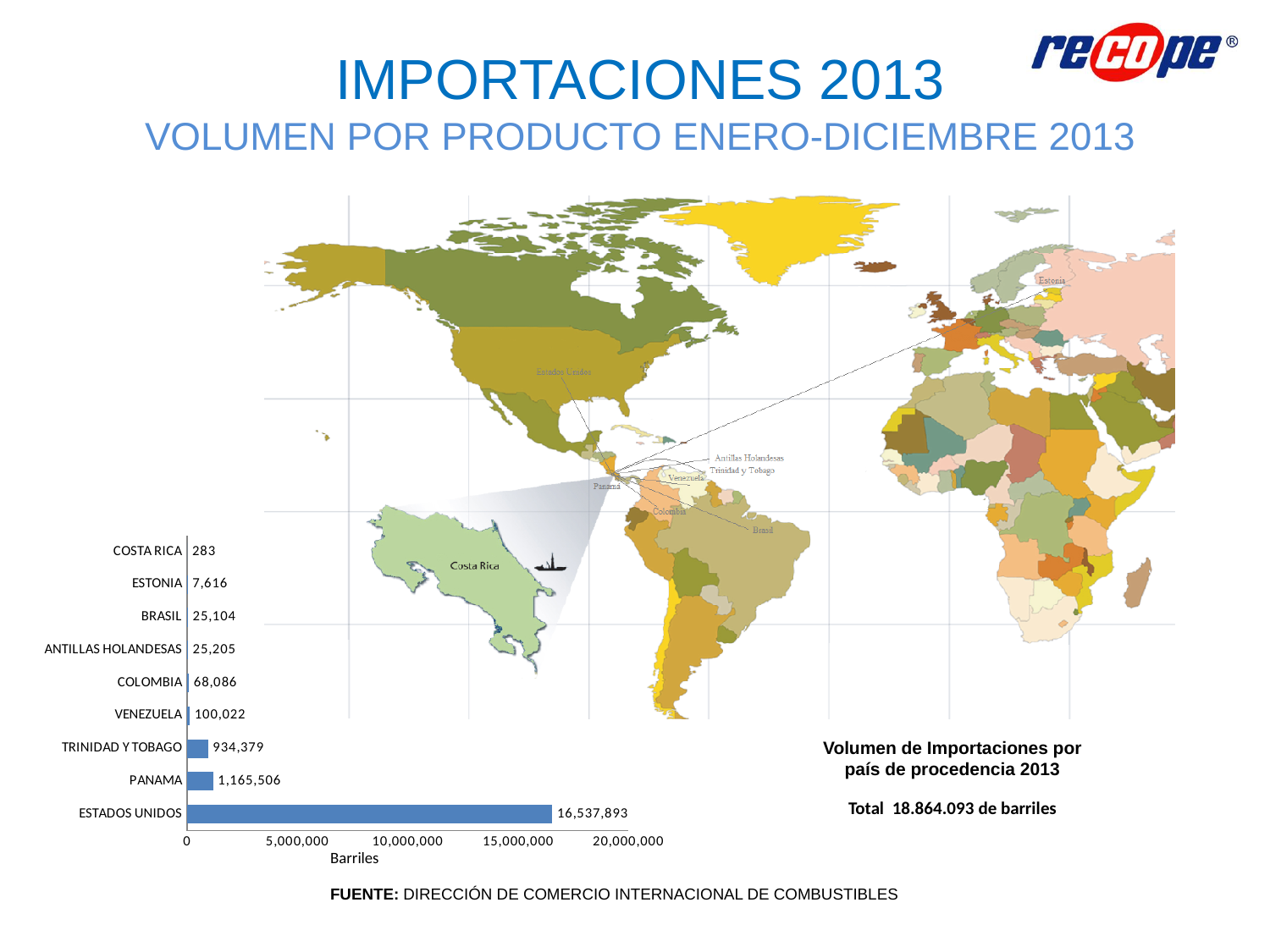
Which is larger, the value for PANAMA or the value for TRINIDAD Y TOBAGO? PANAMA What is the value for ESTONIA in the bar chart? 7,616 Which country has the highest value in the bar chart? ESTADOS UNIDOS What is the label of the horizontal axis of the bar chart? Barriles What kind of chart is shown on the slide? bar chart What is the value for VENEZUELA in the bar chart? 100,022 What is the value for ESTADOS UNIDOS in the bar chart? 16,537,893 How many countries are shown in the bar chart? 9 Is the value for ESTADOS UNIDOS greater or less than 15,000,000? greater What is the difference between the values for PANAMA and TRINIDAD Y TOBAGO? 231,127 Which country has the lowest value in the bar chart? COSTA RICA What is the value for PANAMA in the bar chart? 1,165,506